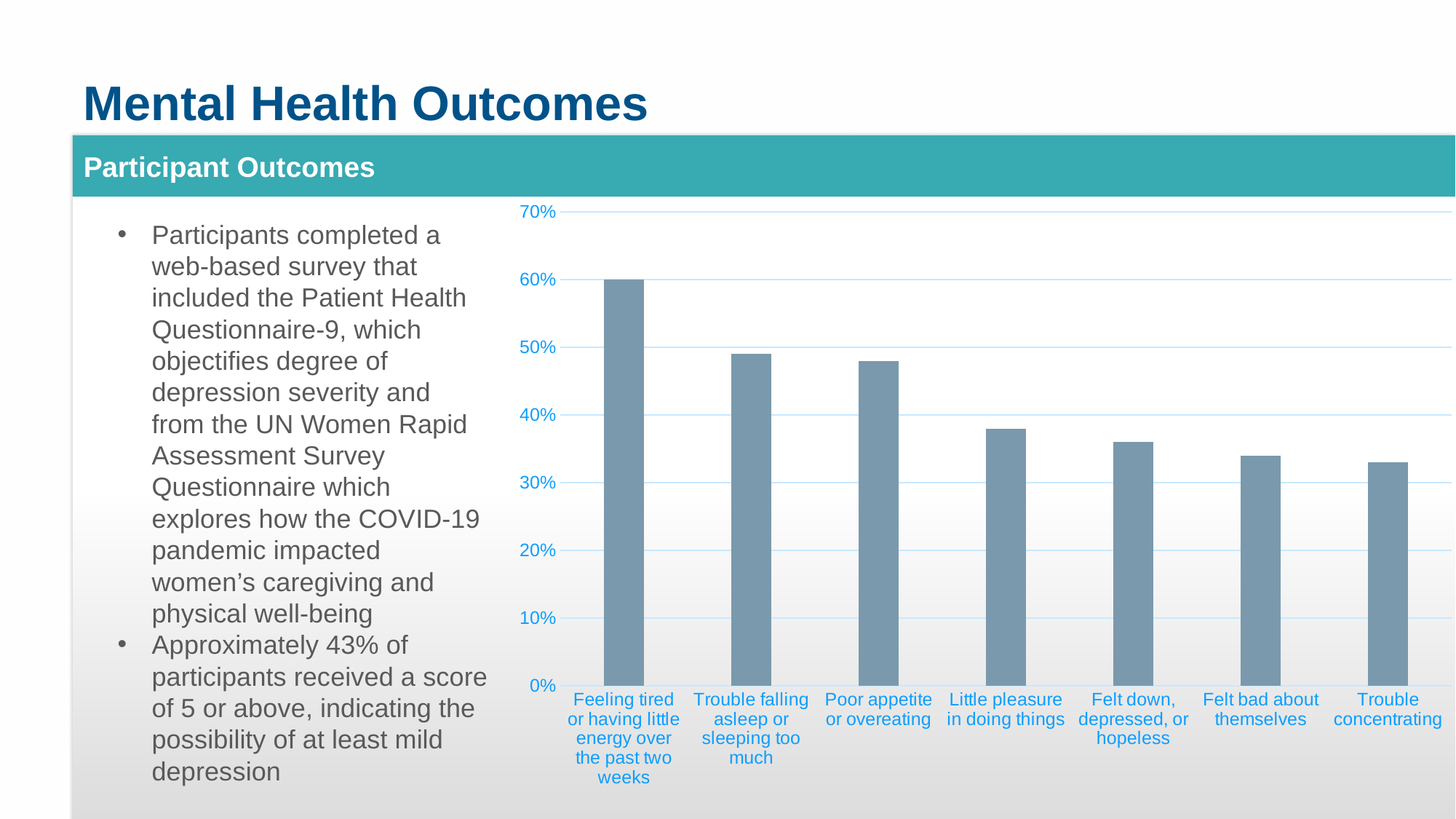
Which is larger: the value for 'Feeling tired or having little energy over the past two weeks' or the value for 'Little pleasure in doing things'? Feeling tired or having little energy over the past two weeks Which category has the highest value in the chart? Feeling tired or having little energy over the past two weeks How many categories are shown on the x axis of the chart? 7 Is the value for 'Felt bad about themselves' greater or less than 40%? less What is the value for 'Feeling tired or having little energy over the past two weeks'? 60% Is the value for 'Felt down, depressed, or hopeless' greater or less than 30%? greater Do the bar values rise or fall from left to right along the x axis? Fall Is the value for 'Trouble concentrating' greater or less than 30%? greater What is the highest value shown on the chart's y axis? 70% What type of chart is shown on the slide? Bar chart